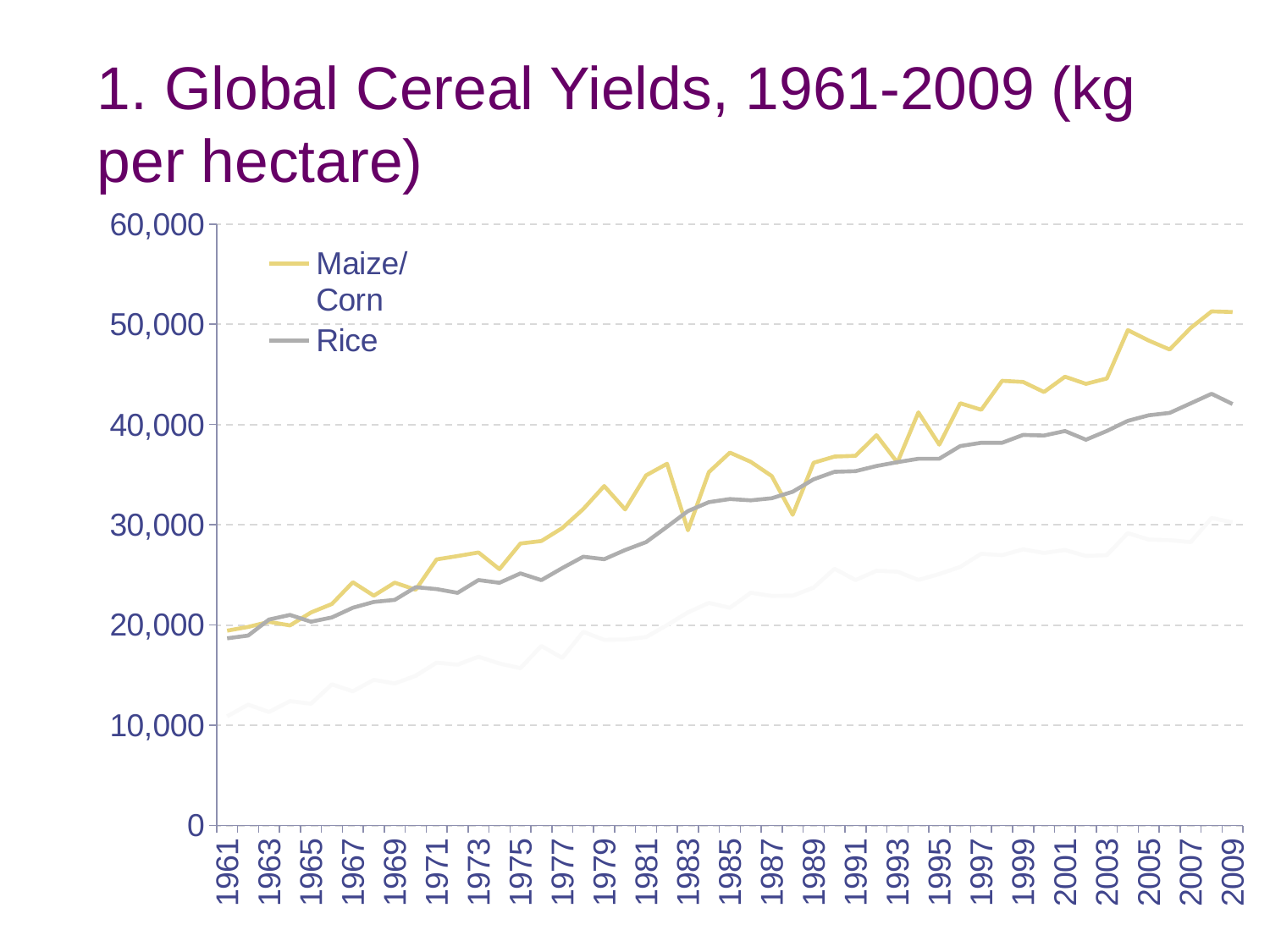
In 1983, which series has the higher value, Maize/Corn or Rice? Rice In 2009, which series has the higher value, Maize/Corn or Rice? Maize/Corn What kind of chart is shown on the slide? line chart Is the Maize/Corn value for 1985 greater or less than 30,000? greater Is the Rice value for 1961 greater or less than 20,000? less Does the Maize/Corn yield generally rise or fall from 1961 to 2009? rise Does the Rice yield generally rise or fall from 1961 to 2009? rise What colour is the Maize/Corn line? yellow Is the Maize/Corn value for 2009 greater or less than 50,000? greater How many series does the legend list? 2 What is the title of the chart? 1. Global Cereal Yields, 1961-2009 (kg per hectare)